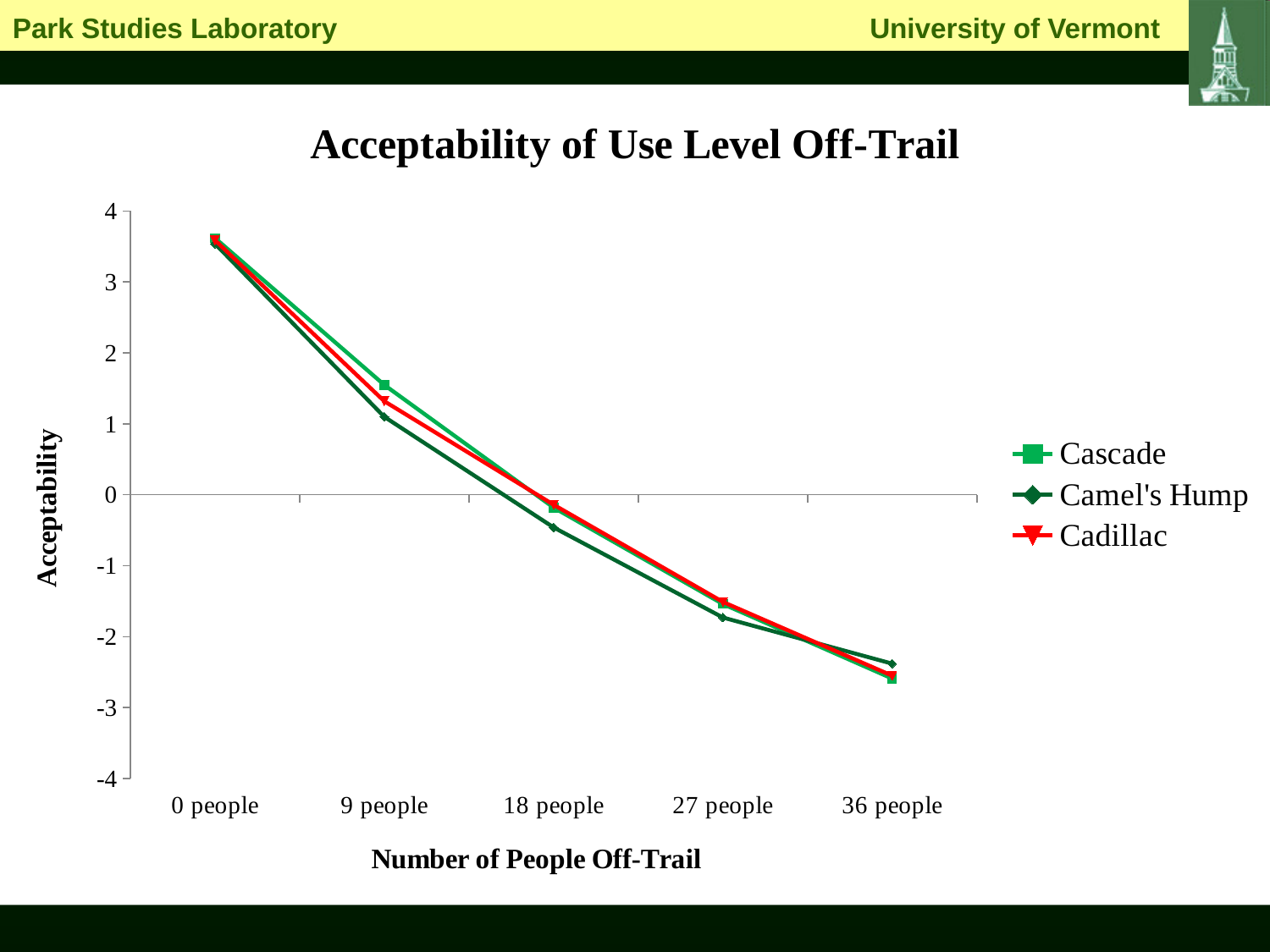
How many series does the legend list? 3 At which number of people off-trail is acceptability highest for all three series? 0 people How many use-level categories are shown on the x axis? 5 Is the value for Cadillac at 36 people greater or less than -2? less At 9 people, which series has the higher acceptability, Cascade or Camel's Hump? Cascade Is the value for Camel's Hump at 18 people greater or less than 0? less Is the value for Camel's Hump at 27 people greater or less than -1? less Do the acceptability values rise or fall as the number of people off-trail increases? fall What kind of chart is shown on the slide? line chart What is the title of the chart? Acceptability of Use Level Off-Trail